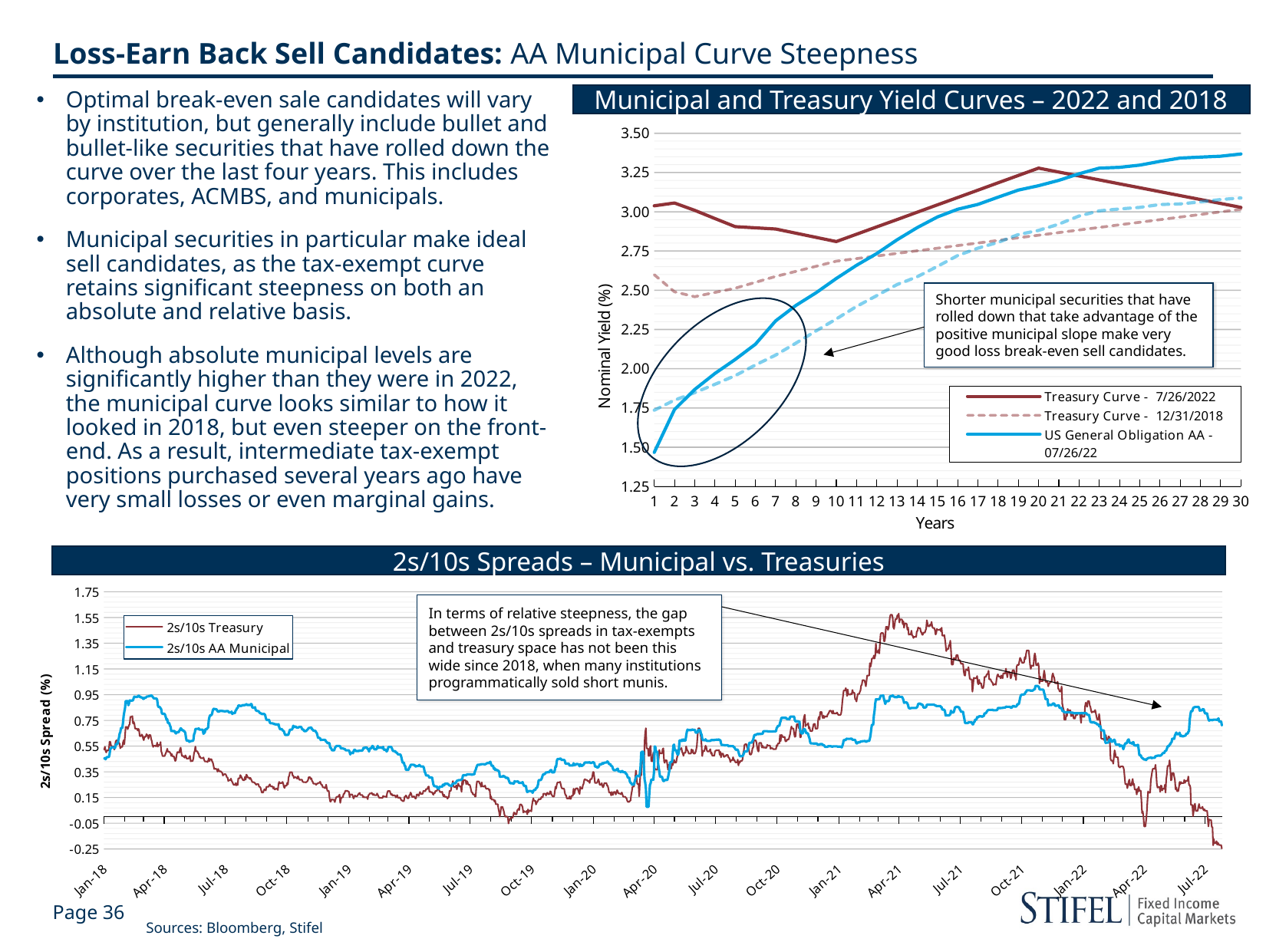
In the 'Municipal and Treasury Yield Curves – 2022 and 2018' chart, does the US General Obligation AA - 07/26/22 curve rise or fall as the years increase? Rise How many series does the legend of the 'Municipal and Treasury Yield Curves – 2022 and 2018' chart list? 3 In the '2s/10s Spreads – Municipal vs. Treasuries' chart, which series is higher at the end of the period (Jul-22): 2s/10s Treasury or 2s/10s AA Municipal? 2s/10s AA Municipal What kind of chart is the 'Municipal and Treasury Yield Curves – 2022 and 2018' chart? Line chart What is the title of the chart at the bottom of the slide? 2s/10s Spreads – Municipal vs. Treasuries In the 'Municipal and Treasury Yield Curves – 2022 and 2018' chart, is the Treasury Curve - 7/26/2022 value at year 10 greater or less than 2.50? greater How many series does the legend of the '2s/10s Spreads – Municipal vs. Treasuries' chart list? 2 How many points along the Years axis does the 'Municipal and Treasury Yield Curves – 2022 and 2018' chart show? 30 In the '2s/10s Spreads – Municipal vs. Treasuries' chart, is the peak of the 2s/10s Treasury series around Apr-21 greater or less than 1.35? greater In the 'Municipal and Treasury Yield Curves – 2022 and 2018' chart, which series has the higher value at year 30: Treasury Curve - 7/26/2022 or US General Obligation AA - 07/26/22? US General Obligation AA - 07/26/22 In the 'Municipal and Treasury Yield Curves – 2022 and 2018' chart, which series has the higher value at year 1: Treasury Curve - 7/26/2022 or US General Obligation AA - 07/26/22? Treasury Curve - 7/26/2022 In the 'Municipal and Treasury Yield Curves – 2022 and 2018' chart, is the US General Obligation AA - 07/26/22 value at year 1 greater or less than 2.00? less